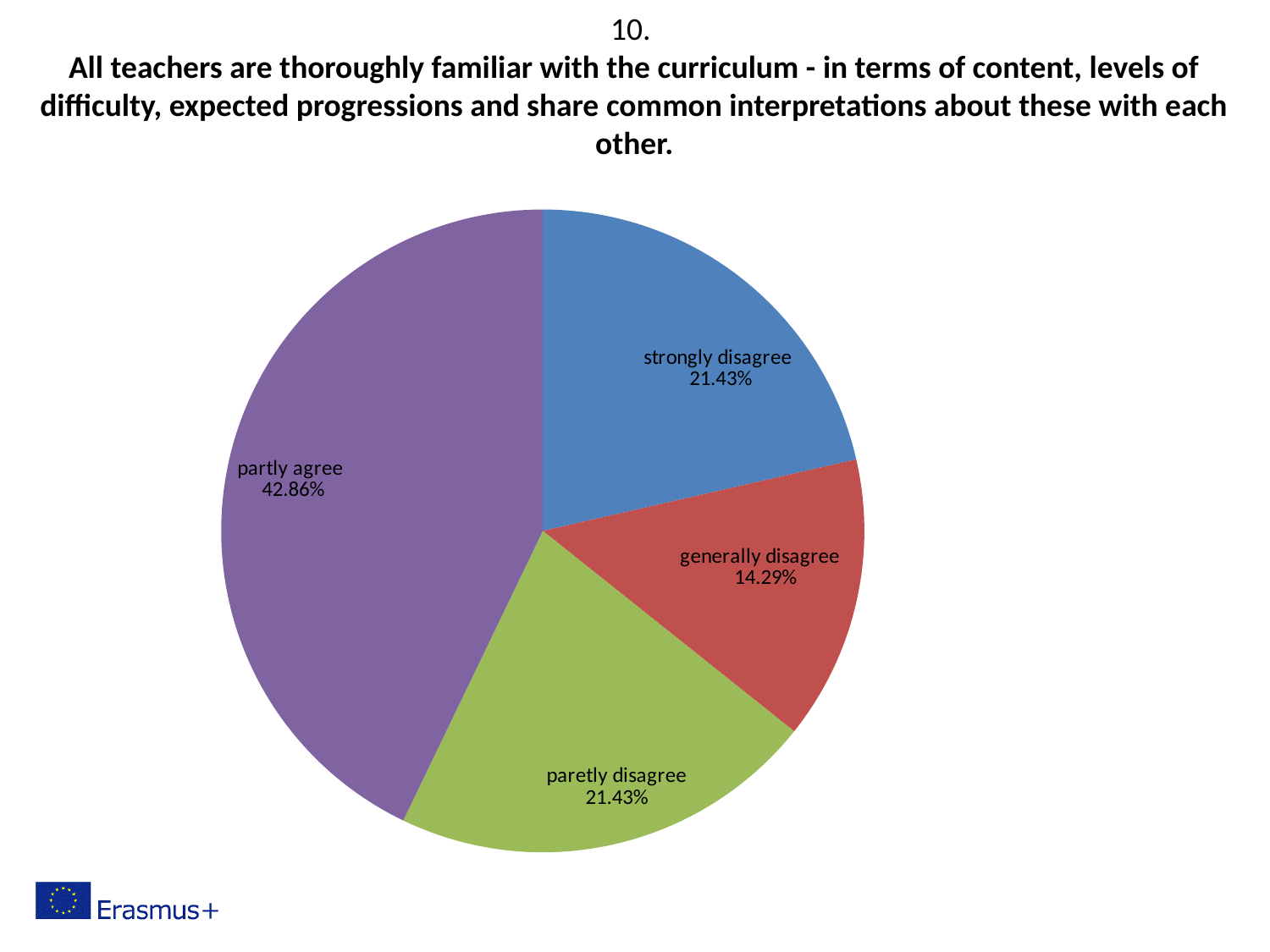
What kind of chart is shown on the slide? pie chart What share of the pie is labelled 'generally disagree'? 14.29% Which slice of the pie is the smallest? generally disagree What is the difference between the 'partly agree' share and the 'strongly disagree' share? 21.43% What share of the pie is labelled 'strongly disagree'? 21.43% What share of the pie is labelled 'paretly disagree'? 21.43% Which slice of the pie is the largest? partly agree Which is larger, the 'strongly disagree' slice or the 'generally disagree' slice? strongly disagree How many slices does the pie chart have? 4 What colour is the 'partly agree' slice? purple What is the difference between the 'partly agree' share and the 'generally disagree' share? 28.57%